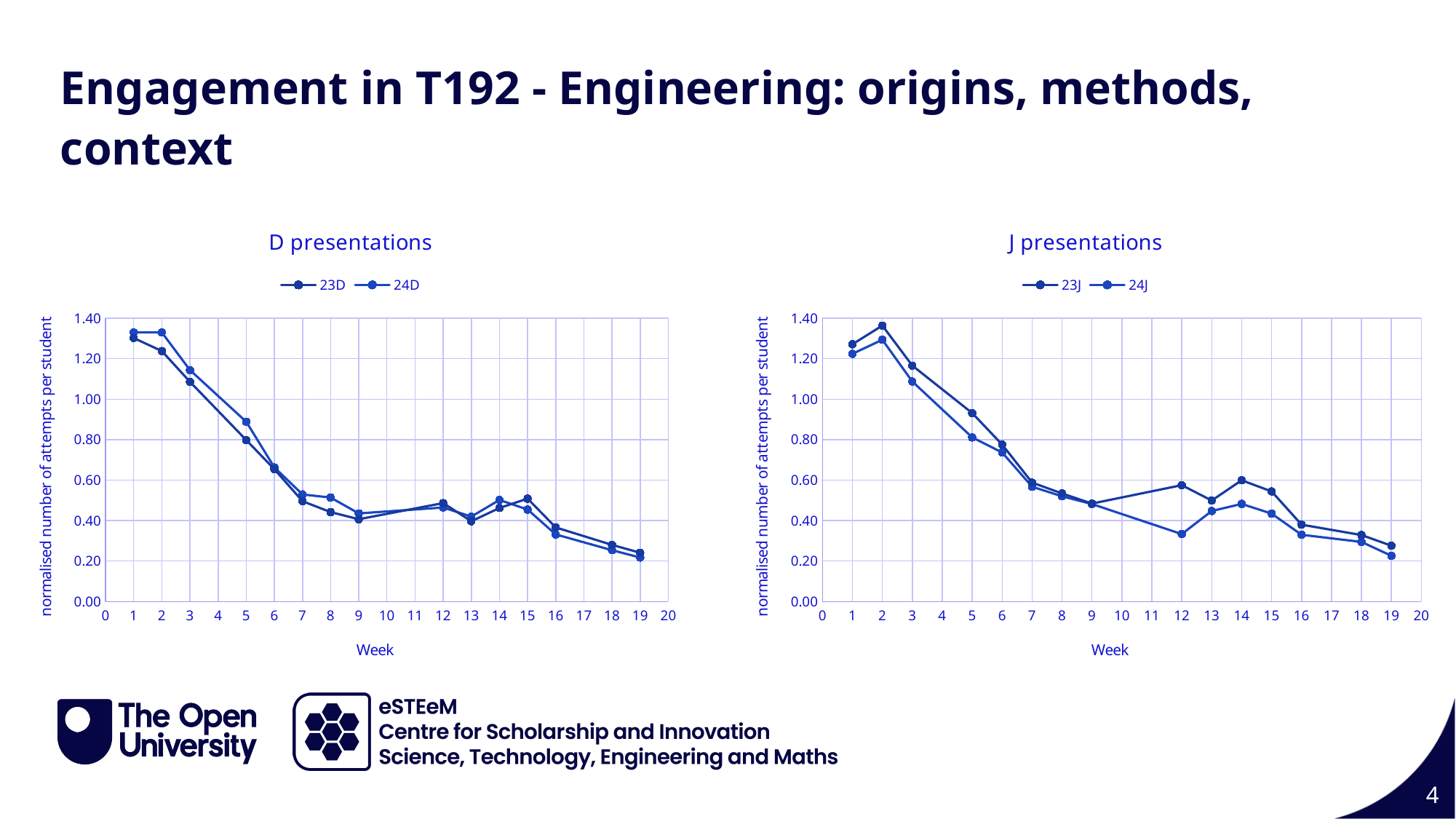
What is the y-axis label on the 'J presentations' chart? normalised number of attempts per student What are the two series named in the legend of the 'D presentations' chart? 23D and 24D How many series does the legend of the 'J presentations' chart list? 2 In the 'J presentations' chart, which series has the larger value at week 12, 23J or 24J? 23J In the 'J presentations' chart, at which week does 24J reach its highest value? Week 2 In the 'D presentations' chart, is the value for 23D at week 1 greater or less than 1.20? greater In the 'D presentations' chart, is the value for 24D at week 5 greater or less than 0.80? greater In the 'J presentations' chart, is the value for 24J at week 12 greater or less than 0.40? less In the 'D presentations' chart, do the values for 24D generally rise or fall as the week increases? fall What kind of chart is the 'D presentations' chart? line chart In the 'J presentations' chart, do the values for 23J generally rise or fall from week 2 to week 19? fall